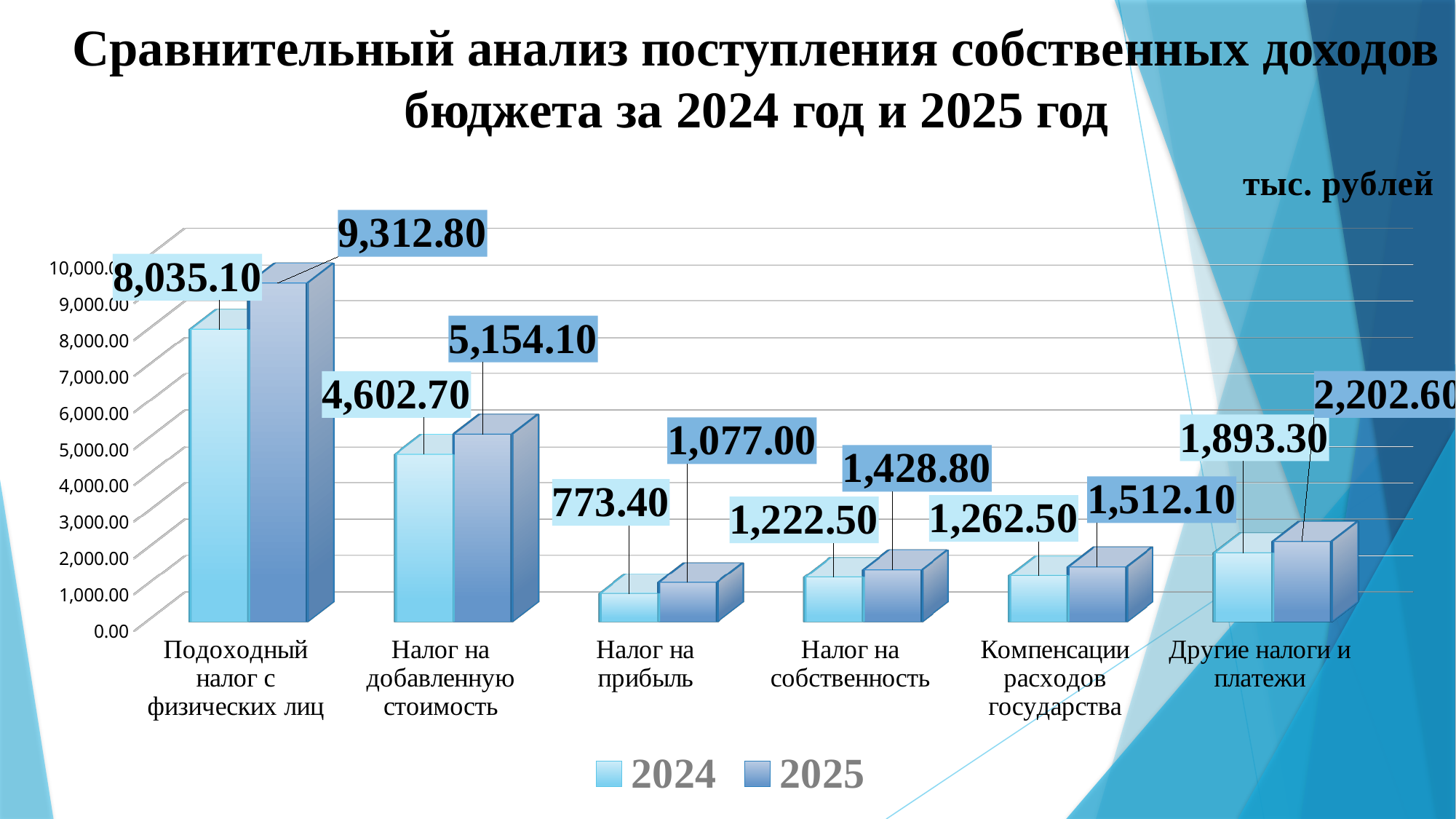
Which category has the highest 2025 value? Подоходный налог с физических лиц Is the 2024 value for Налог на прибыль greater or less than 1,000.00? less Which is larger for Налог на собственность: the 2024 value or the 2025 value? 2025 What is the 2025 value for Налог на добавленную стоимость? 5,154.10 What is the 2025 value for Компенсации расходов государства? 1,512.10 Which category has the lowest 2024 value? Налог на прибыль What is the 2024 value for Налог на прибыль? 773.40 What is the difference between the 2025 and 2024 values for Налог на добавленную стоимость? 551.40 How many categories are shown on the x axis? 6 How many series does the legend list? 2 What is the difference between the 2025 and 2024 values for Подоходный налог с физических лиц? 1,277.70 What is the 2024 value for Подоходный налог с физических лиц? 8,035.10